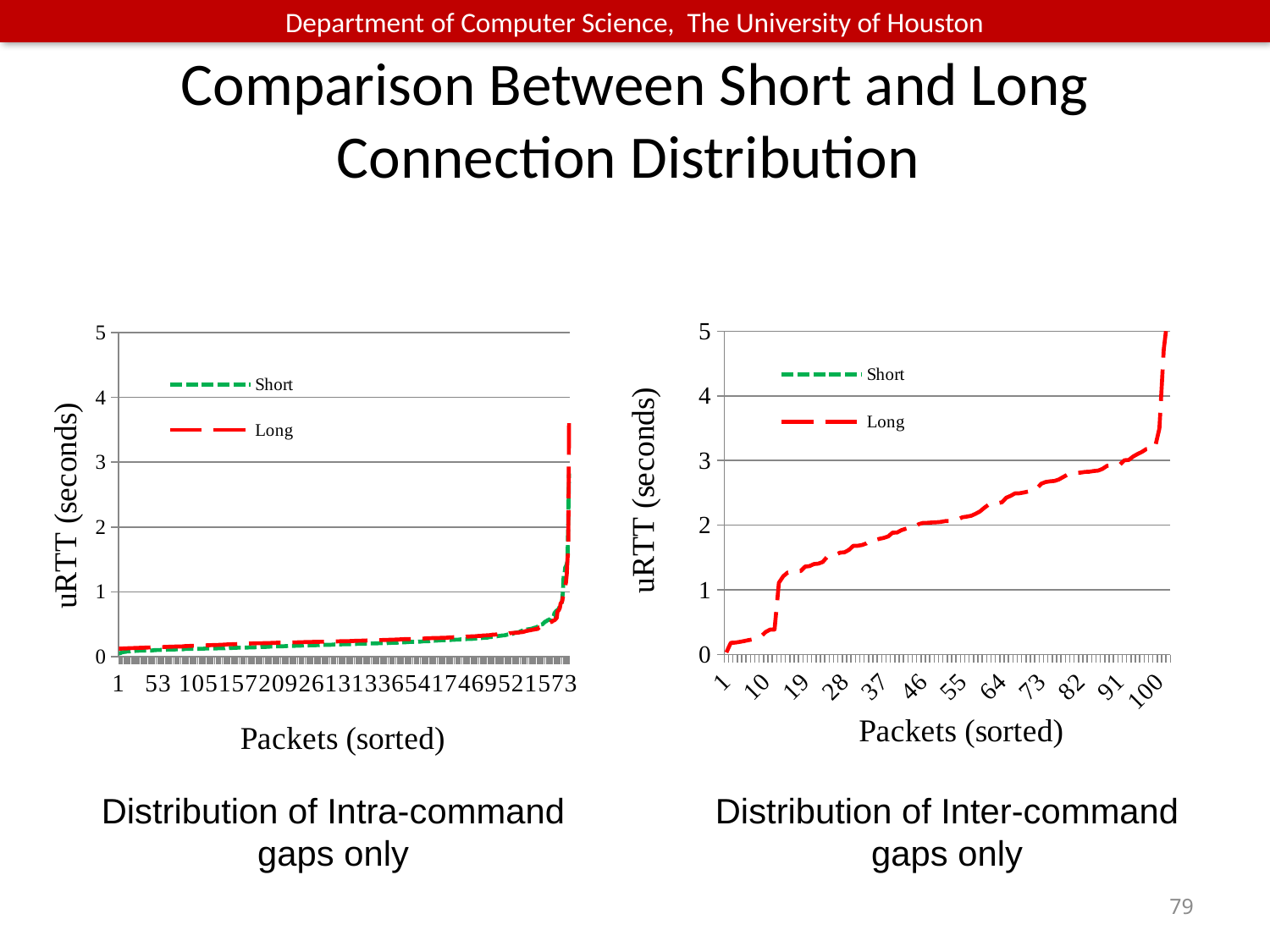
In the right chart, 'Distribution of Inter-command gaps only', do the values rise or fall along the x axis? rise What is the y-axis title of the left chart, 'Distribution of Intra-command gaps only'? uRTT (seconds) In the right chart, 'Distribution of Inter-command gaps only', is the Long value at packet 1 greater or less than 1? less How many series does the legend of the right chart, 'Distribution of Inter-command gaps only', list? 2 What kind of chart is the left chart, 'Distribution of Intra-command gaps only'? line chart In the right chart, 'Distribution of Inter-command gaps only', is the Long value at packet 28 greater or less than 1? greater How many series does the legend of the left chart, 'Distribution of Intra-command gaps only', list? 2 What are the two series named in the legend of the right chart, 'Distribution of Inter-command gaps only'? Short and Long In the left chart, 'Distribution of Intra-command gaps only', do the values rise or fall along the x axis? rise In the left chart, 'Distribution of Intra-command gaps only', is the Long value at packet 1 greater or less than 1? less What kind of chart is the right chart, 'Distribution of Inter-command gaps only'? line chart